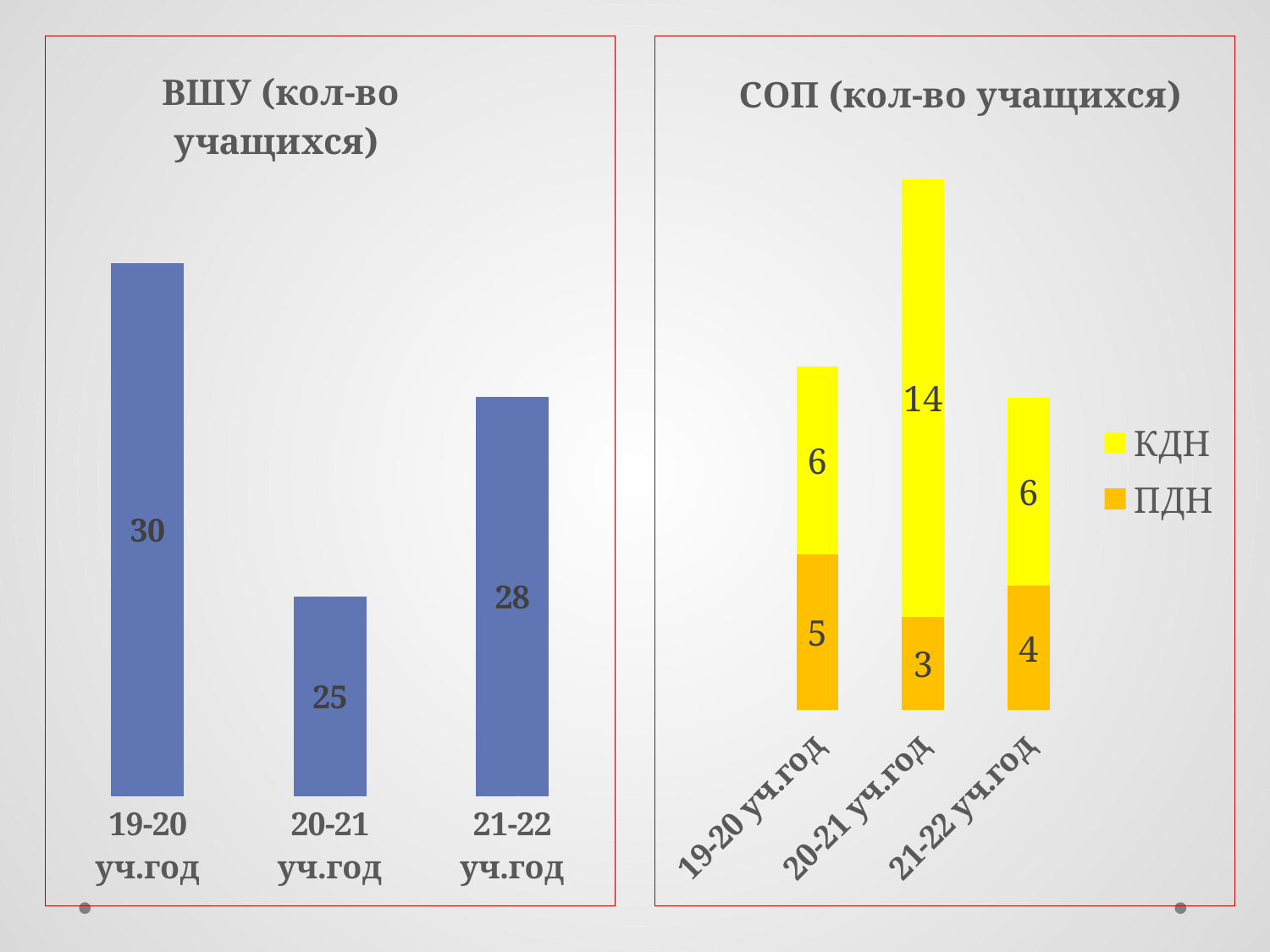
In the chart titled "СОП (кол-во учащихся)", what is the ПДН value for 21-22 уч.год? 4 What kind of chart is the chart titled "ВШУ (кол-во учащихся)"? bar chart In the chart titled "СОП (кол-во учащихся)", what is the КДН value for 20-21 уч.год? 14 In the chart titled "СОП (кол-во учащихся)", which is larger, the ПДН value for 19-20 уч.год or the ПДН value for 20-21 уч.год? 19-20 уч.год In the chart titled "ВШУ (кол-во учащихся)", which year has the highest value? 19-20 уч.год In the chart titled "СОП (кол-во учащихся)", what is the total of the stacked bar for 20-21 уч.год? 17 In the chart titled "ВШУ (кол-во учащихся)", how many categories are shown on the x axis? 3 In the chart titled "ВШУ (кол-во учащихся)", what is the difference between the values for 19-20 уч.год and 21-22 уч.год? 2 In the chart titled "ВШУ (кол-во учащихся)", which year has the lowest value? 20-21 уч.год In the chart titled "СОП (кол-во учащихся)", which colour represents the КДН series? yellow In the chart titled "ВШУ (кол-во учащихся)", what is the value for 20-21 уч.год? 25 In the chart titled "СОП (кол-во учащихся)", how many series does the legend list? 2